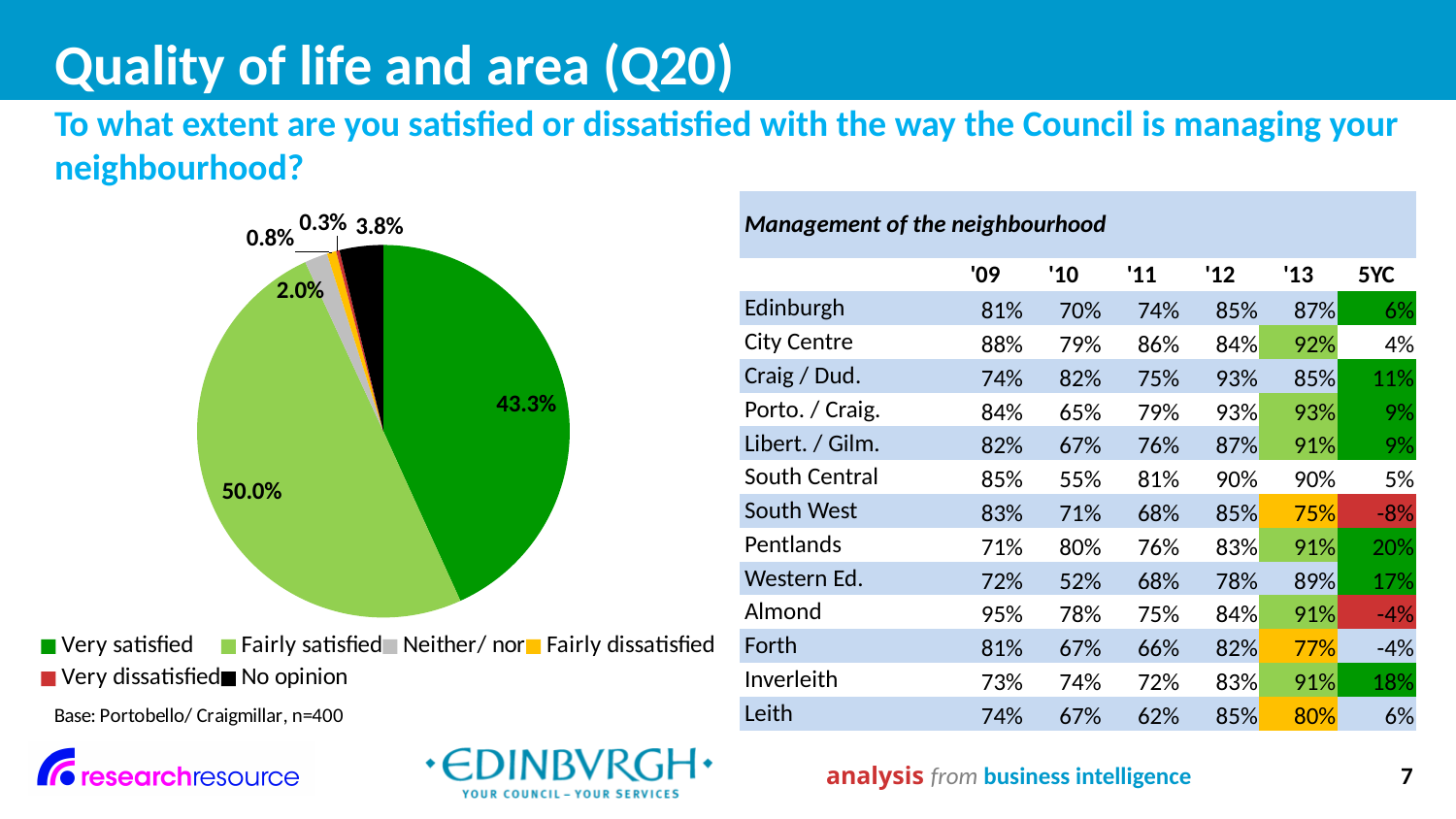
What is the combined share of Very satisfied and Fairly satisfied in the pie chart? 93.3% Which category has the smallest slice of the pie chart? Very dissatisfied How many categories does the pie chart legend list? 6 What share of the pie chart is Neither/ nor? 2.0% What is the base (sample size) stated below the pie chart? Portobello/ Craigmillar, n=400 What share of the pie chart is No opinion? 3.8% What share of the pie chart is Very satisfied? 43.3% What is the difference between the Fairly satisfied and Very satisfied shares in the pie chart? 6.7% What share of the pie chart is Fairly satisfied? 50.0% Which is larger in the pie chart, No opinion or Neither/ nor? No opinion Which category has the largest slice of the pie chart? Fairly satisfied What kind of chart is shown on the left of the slide? Pie chart